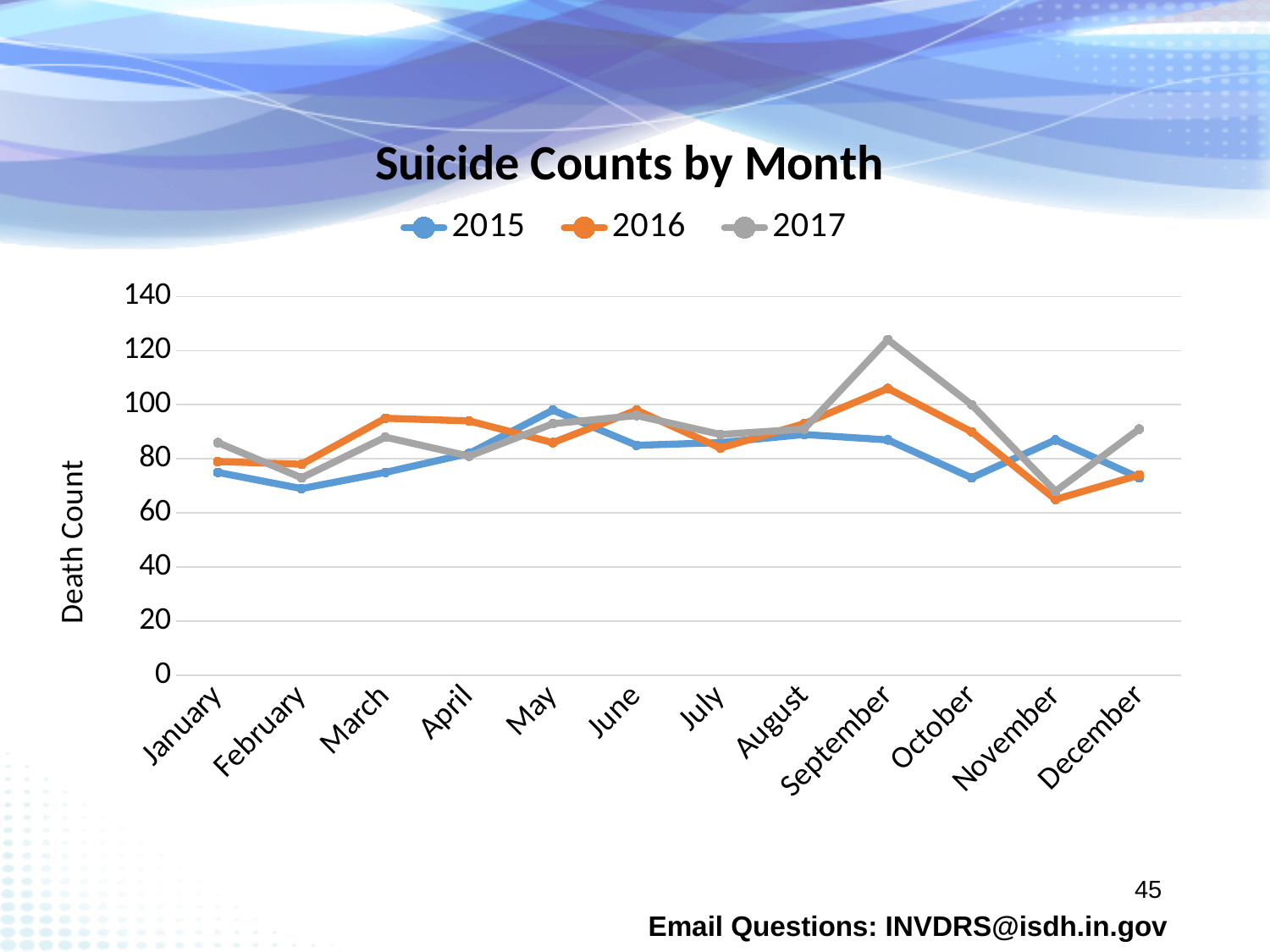
Is the value for 2016 in November greater or less than 80? less In which month does the 2016 series reach its lowest value? November In September, which series has the larger value, 2015 or 2017? 2017 Is the value for 2017 in September greater or less than 100? greater What is the label on the vertical axis? Death Count Is the value for 2015 in February greater or less than 80? less In which month does the 2016 series reach its highest value? September What kind of chart is shown on the slide? line chart How many months are plotted along the x axis? 12 In which month does the 2017 series reach its highest value? September How many series does the legend list? 3 In which month does the 2015 series reach its highest value? May